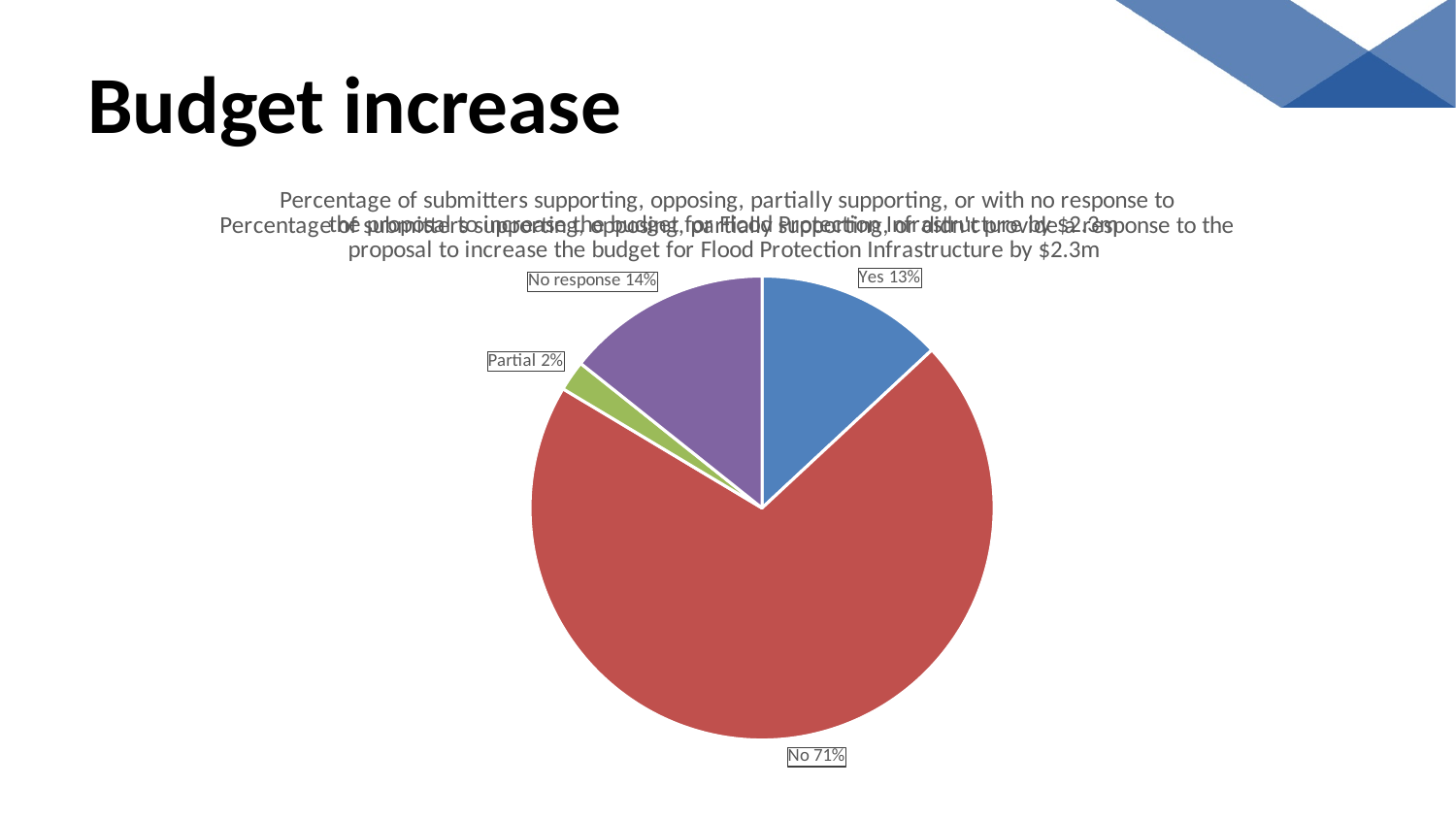
What colour is the "No" slice of the pie? Red What share of the pie is labelled "No response"? 14% What is the difference in percentage points between the "No" and "Yes" slices? 58 What type of chart is shown on the slide? Pie chart What is the difference in percentage points between the "No response" and "Partial" slices? 12 Which response category has the smallest slice of the pie? Partial What percentage of submitters answered "Yes"? 13% What percentage of submitters gave a "Partial" response? 2% Which is larger, the "No response" slice or the "Yes" slice? No response What percentage of submitters answered "No" to the budget increase proposal? 71% How many slices does the pie chart have? 4 Which response category has the largest slice of the pie? No